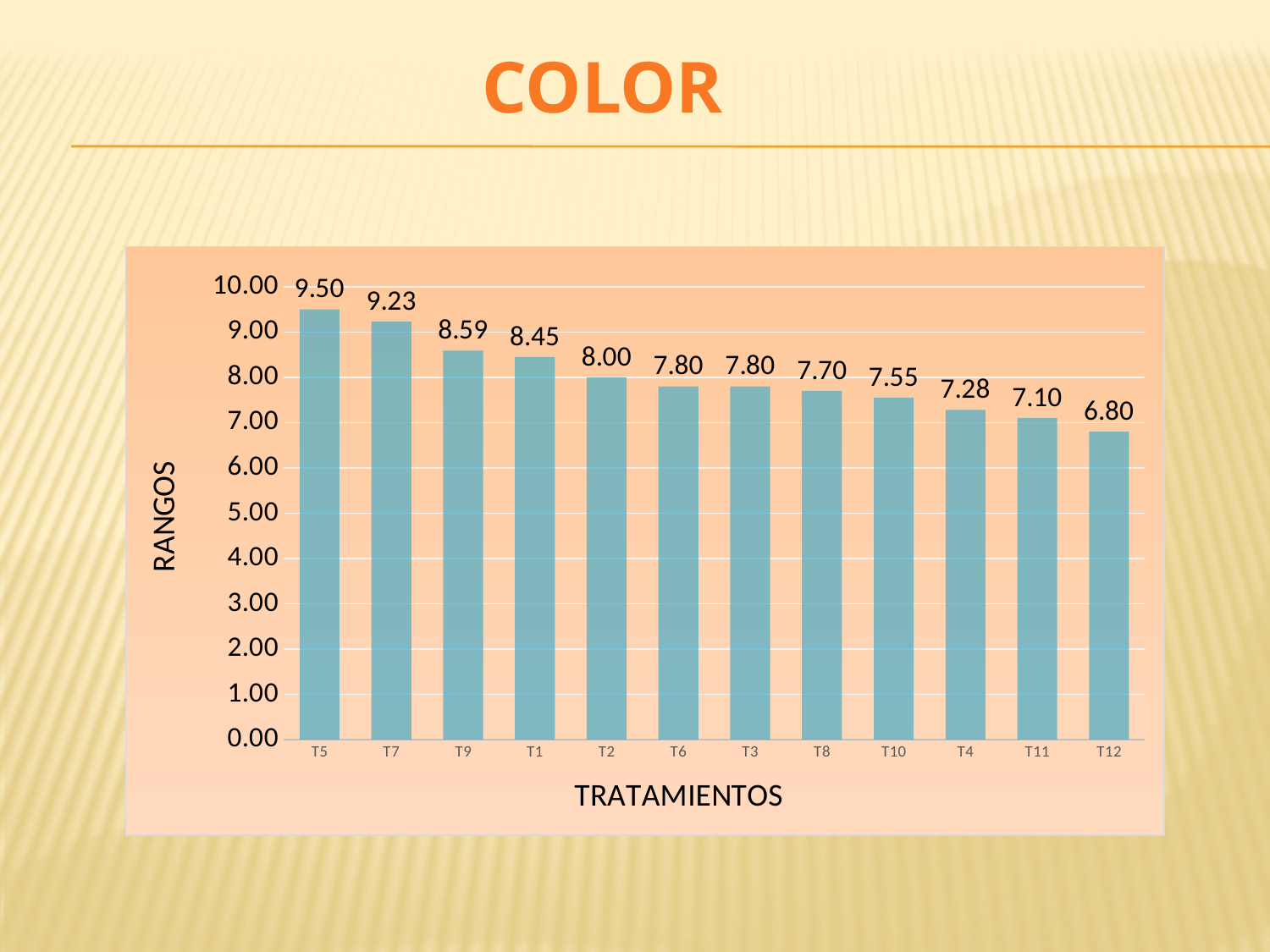
How many treatments are shown on the x axis? 12 What kind of chart is shown on the slide? Bar chart What is the difference between the values for T7 and T9? 0.64 Which treatment has the highest value? T5 Do the values rise or fall from left to right along the x axis? Fall What is the value for T10? 7.55 What is the difference between the values for T5 and T12? 2.70 What is the value for T1? 8.45 Which is larger, the value for T2 or the value for T4? T2 What is the label of the y axis? RANGOS What is the value for T5? 9.50 Which treatment has the lowest value? T12